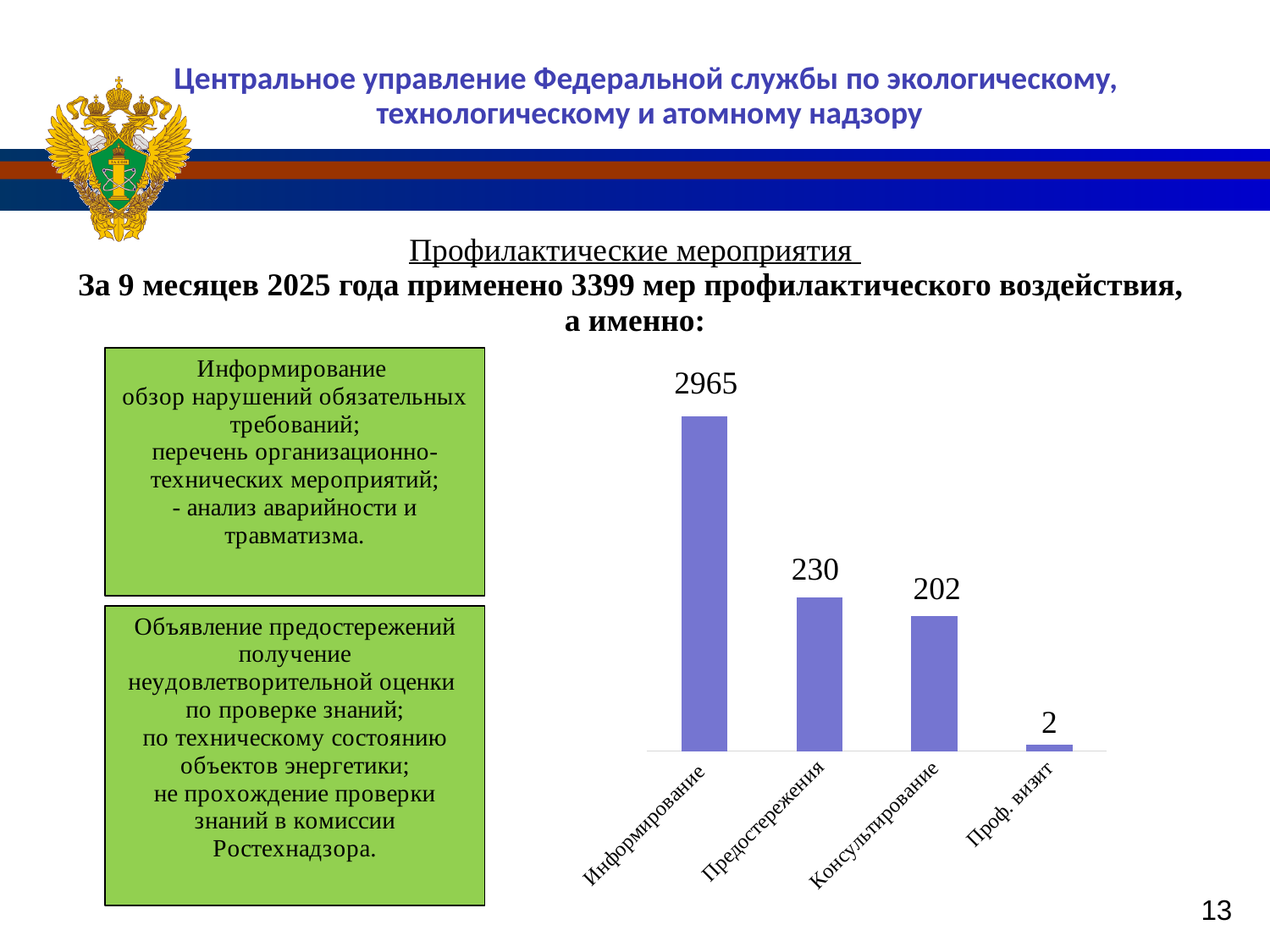
What is the value for Консультирование? 202 What kind of chart is shown on the slide? Bar chart What is the value for Проф. визит? 2 What is the value for Предостережения? 230 What is the difference between the values for Предостережения and Консультирование? 28 Which is larger, the value for Предостережения or the value for Консультирование? Предостережения Which category has the highest value? Информирование What is the difference between the values for Информирование and Предостережения? 2735 How many categories are shown in the chart? 4 Do the values rise or fall from left to right along the x axis? Fall What is the value for Информирование? 2965 Which category has the lowest value? Проф. визит